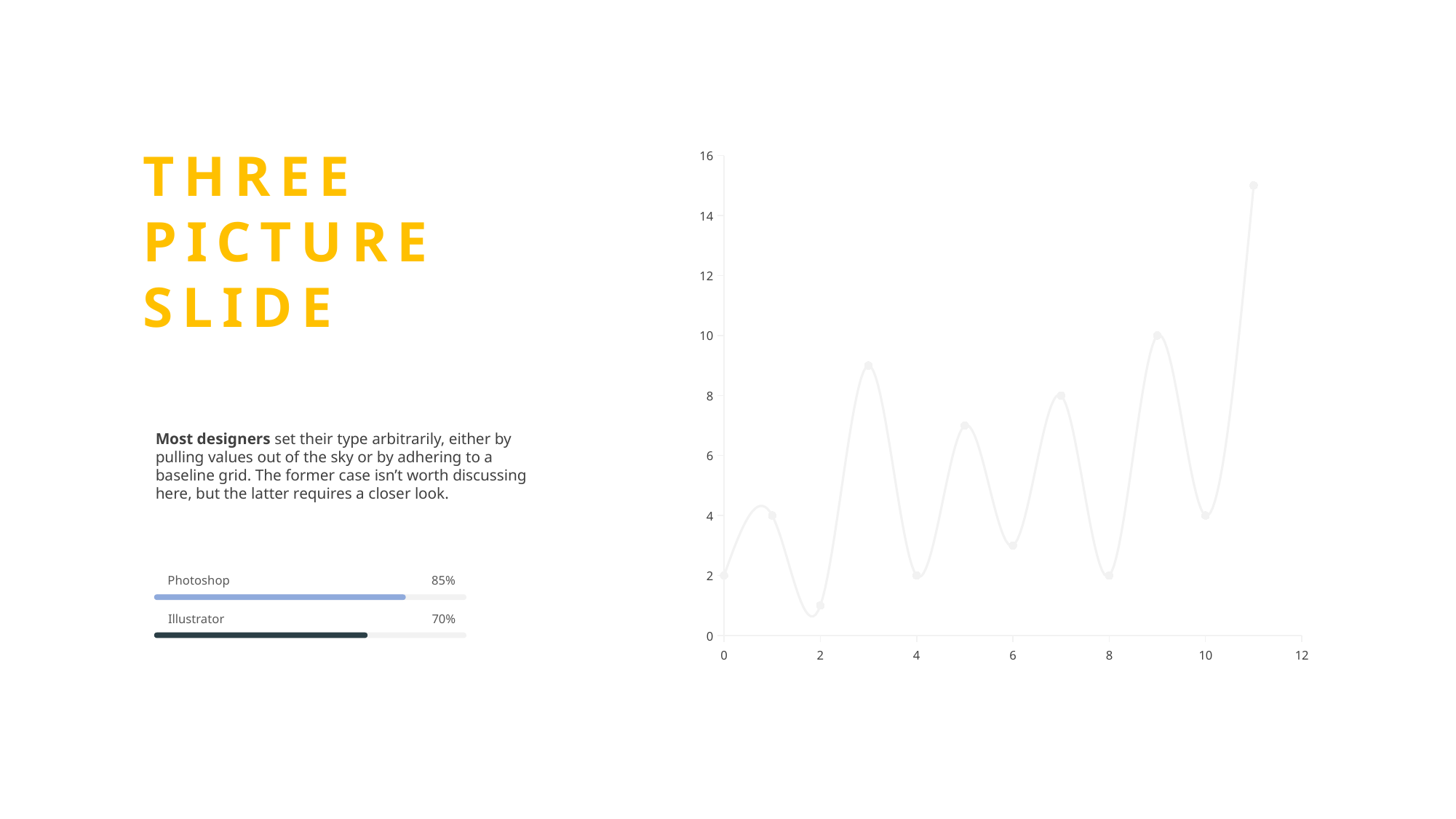
Is the y value of the point at x = 11 greater or less than 14? greater Is the y value of the point at x = 3 greater or less than 8? greater What is the y value of the point at x = 9? 10 What is the y value of the point at x = 7? 8 How many data points are plotted on the chart? 12 Which point has the larger y value, the one at x = 3 or the one at x = 5? x = 3 What is the maximum value shown on the y axis? 16 What is the difference between the y value at x = 9 and the y value at x = 0? 8 At which x value does the chart reach its lowest y value? 2 At which x value does the chart reach its highest y value? 11 What is the y value of the point at x = 0? 2 What type of chart is shown on the slide? line chart